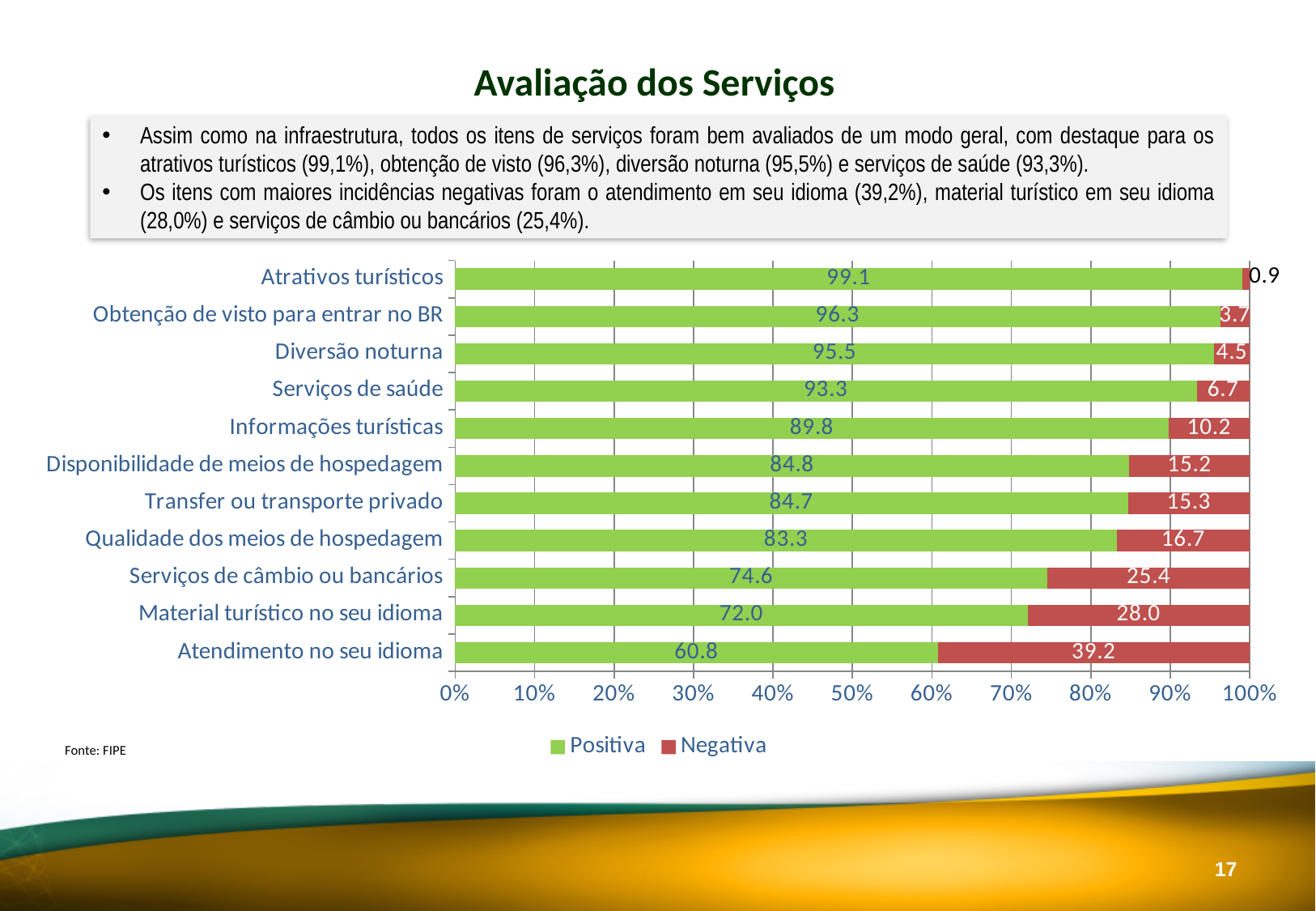
Which category has the lowest Positiva value? Atendimento no seu idioma What is the Positiva value for Serviços de câmbio ou bancários? 74.6 Which is larger, the Positiva value for Diversão noturna or for Serviços de saúde? Diversão noturna How many series does the legend list? 2 What kind of chart is shown on the slide? Stacked bar chart What is the total of the stacked bar for Informações turísticas? 100.0 What is the difference between the Negativa values for Material turístico no seu idioma and Serviços de câmbio ou bancários? 2.6 How many categories are shown in the chart? 11 Which category has the highest Positiva value? Atrativos turísticos Which series is shown in red in the legend? Negativa What is the Positiva value for Atrativos turísticos? 99.1 What is the Negativa value for Atendimento no seu idioma? 39.2